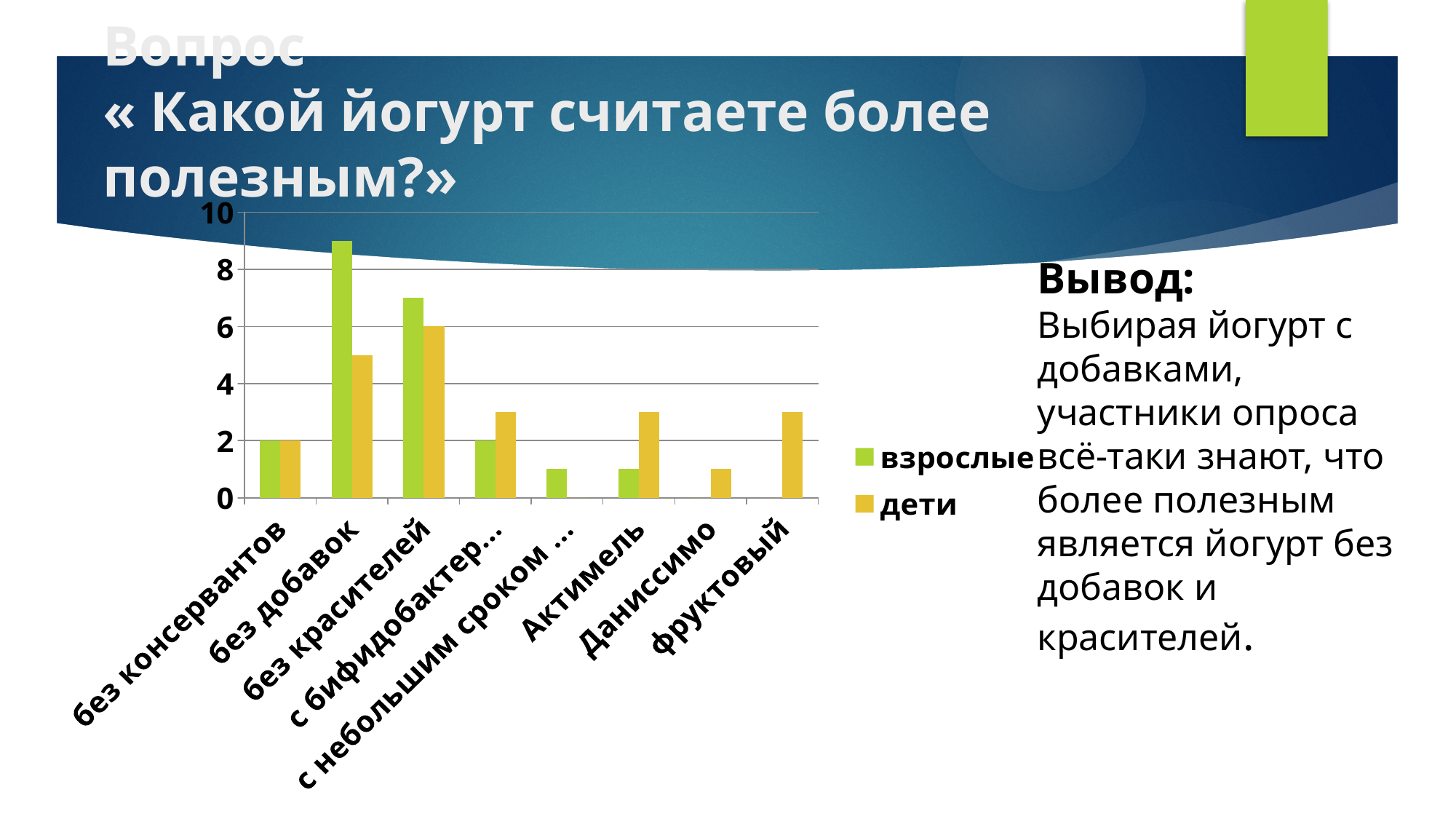
In the category без добавок, which series has the larger value, взрослые or дети? взрослые Is the value for дети in the category Актимель greater or less than 2? greater What is the value for дети in the category без красителей? 6 How many categories are shown on the x axis of the chart? 8 What is the value for взрослые in the category с бифидобактер...? 2 Which category has the highest value for the дети series? без красителей How many series does the chart legend list? 2 Is the value for взрослые in the category без добавок greater or less than 8? greater What kind of chart is shown on the slide? bar chart What is the difference between the взрослые and дети values in the category без консервантов? 0 What is the value for взрослые in the category без консервантов? 2 Which category has the highest value for the взрослые series? без добавок